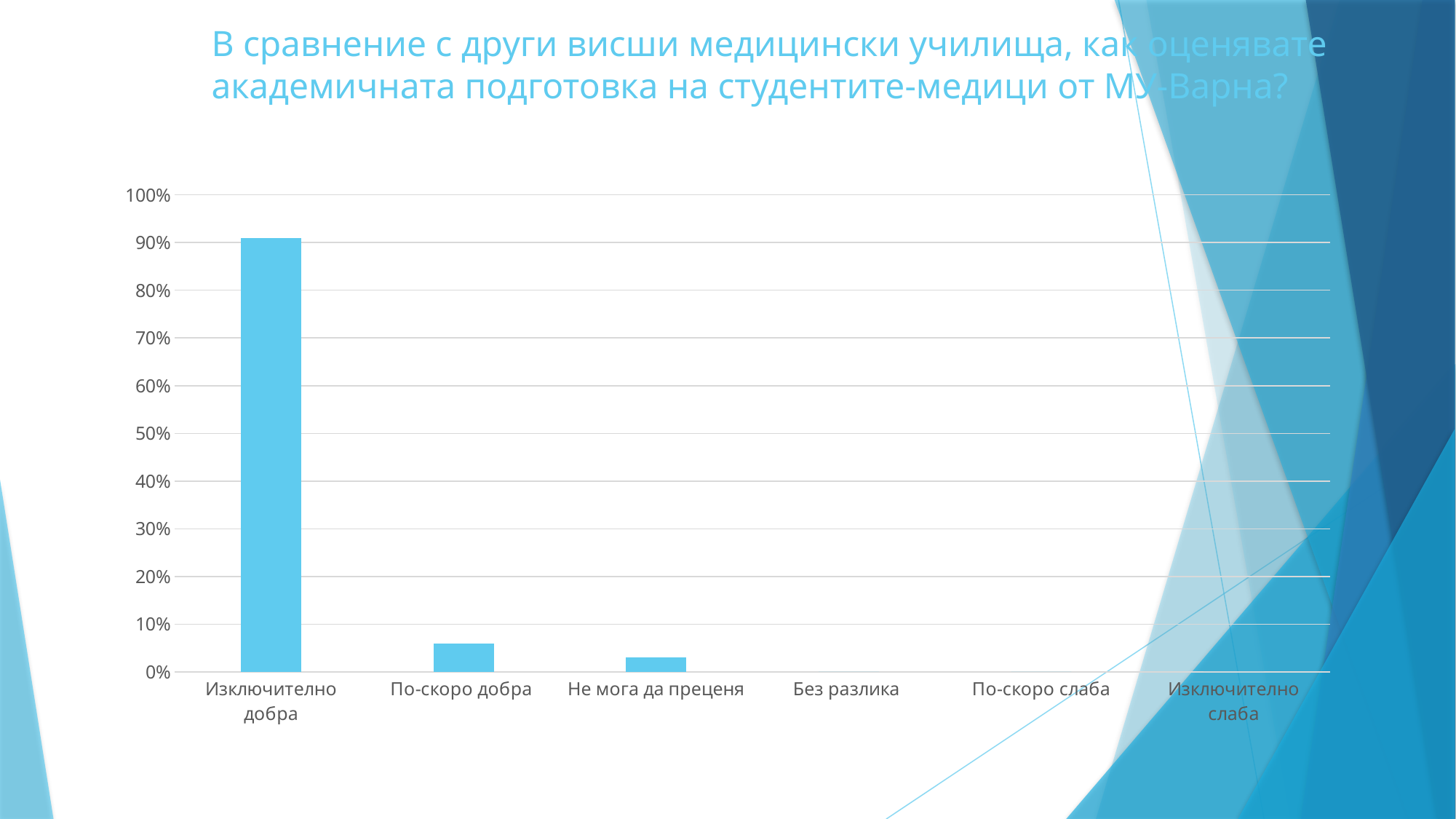
How many categories are shown on the x axis of the chart? 6 Which is larger, the value for По-скоро добра or the value for Не мога да преценя? По-скоро добра What is the highest value shown on the y axis of the chart? 100% Which category has the highest value in the chart? Изключително добра Is the value for Изключително добра greater or less than 80%? greater Do the values generally rise or fall moving from left to right along the x axis? fall What is the label of the last category on the x axis? Изключително слаба Is the value for По-скоро добра greater or less than 10%? less What kind of chart is shown on the slide? bar chart Is the value for Изключително добра greater or less than 50%? greater Which is larger, the value for Изключително добра or the value for По-скоро добра? Изключително добра